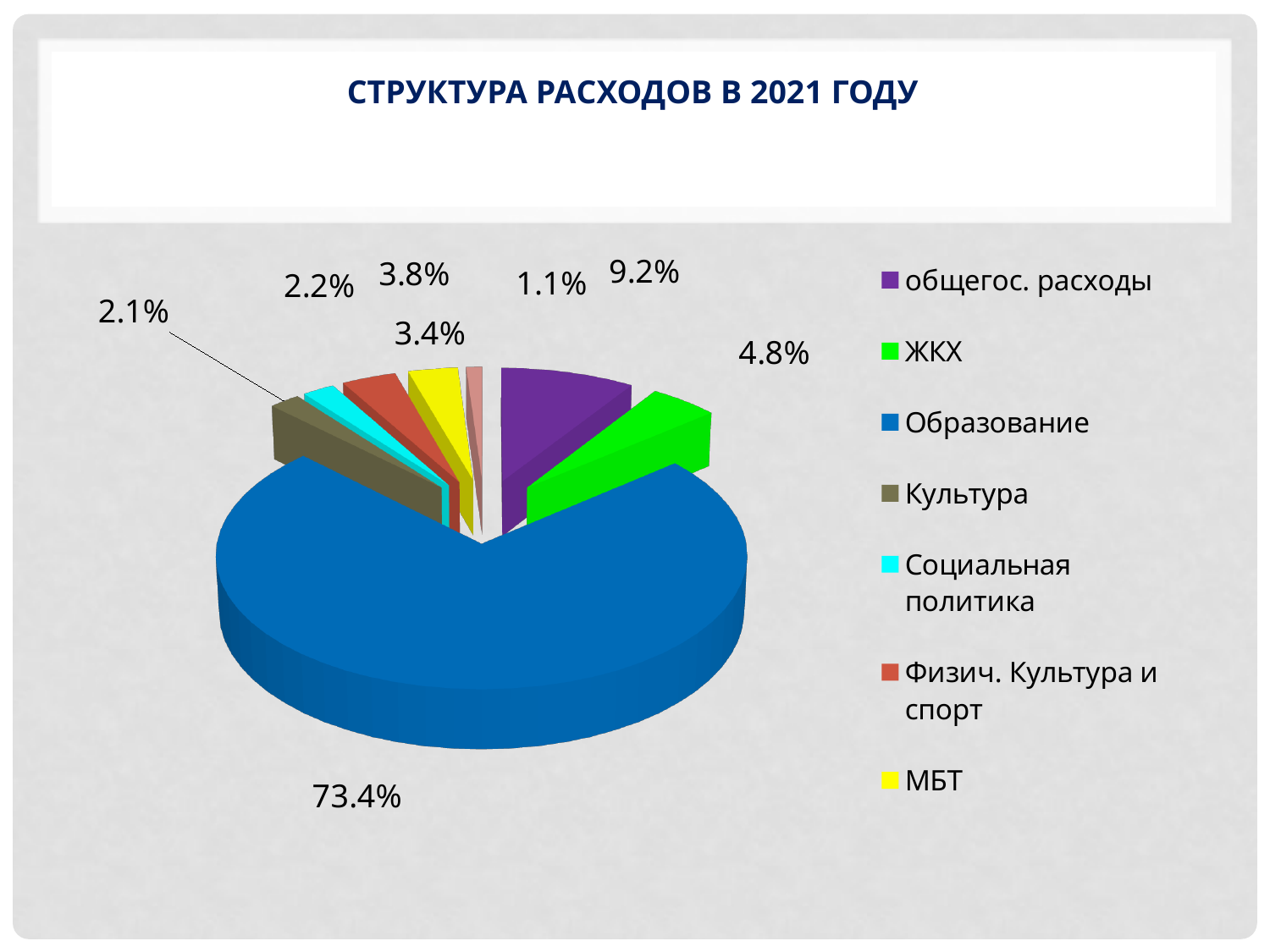
What is the title of the chart? СТРУКТУРА РАСХОДОВ В 2021 ГОДУ What is the largest percentage value shown on the chart? 73.4% What colour is the slice for Образование? blue What share of expenditures does Культура account for? 2.1% By how many percentage points does the share for Образование exceed the share for Культура? 71.3 Which is larger, the share for Образование or the share for Культура? Образование What share of expenditures does Образование account for? 73.4% What is the smallest percentage value shown on the chart? 1.1% Which category has the largest share of the pie? Образование What type of chart is shown on the slide? pie chart How many percentage labels are shown on the pie? 8 How many entries does the legend list? 7